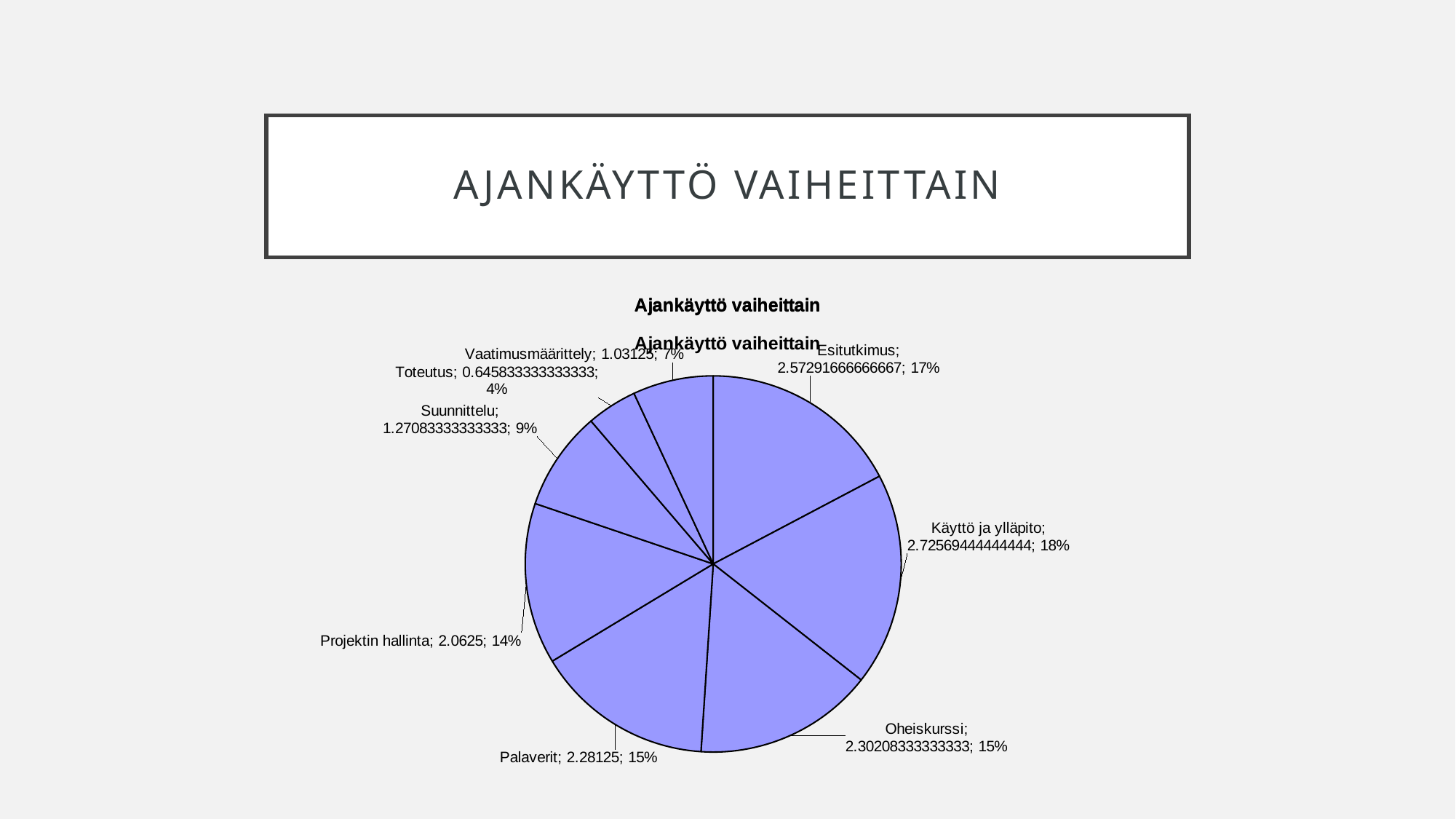
What percentage share does the Esitutkimus slice have? 17% How many slices does the pie chart have? 8 What percentage share does the Käyttö ja ylläpito slice have? 18% What value is shown for Vaatimusmäärittely? 1.03125 Which category has the smallest share of the pie? Toteutus What value is shown for Projektin hallinta? 2.0625 Which is larger, the share for Suunnittelu or the share for Toteutus? Suunnittelu What is the title of the chart? Ajankäyttö vaiheittain What is the difference in percentage points between the Esitutkimus share and the Projektin hallinta share? 3 What kind of chart is shown on the slide? pie chart What value is shown for Palaverit? 2.28125 Which category has the largest share of the pie? Käyttö ja ylläpito